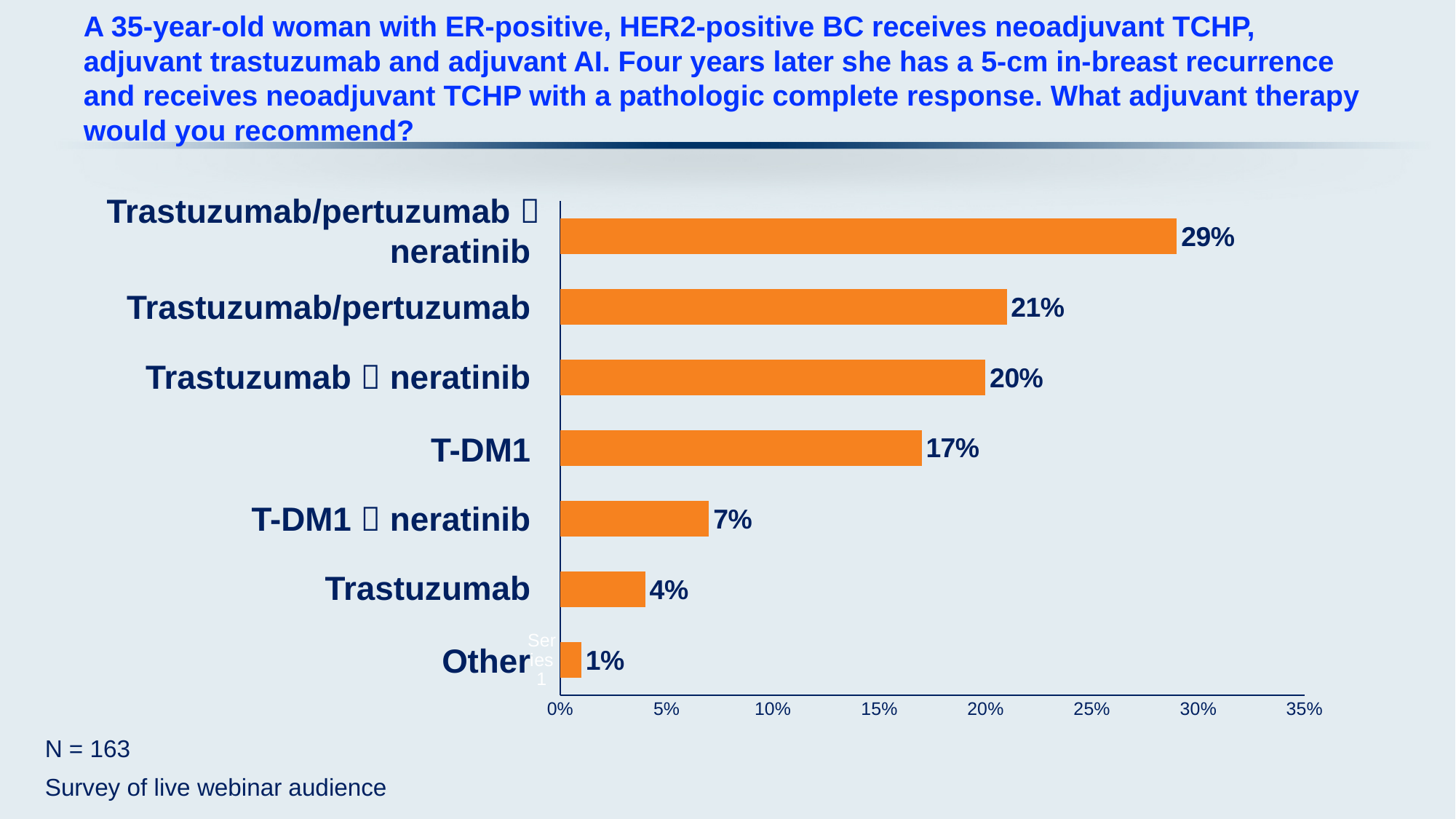
How many categories (response options) are plotted in the chart? 7 Which category has the highest value in the chart? Trastuzumab/pertuzumab followed by neratinib What percentage of respondents chose Other? 1% Which category has the lowest value in the chart? Other What is the value of the top bar, Trastuzumab/pertuzumab followed by neratinib? 29% What percentage of respondents chose Trastuzumab alone? 4% What percentage of respondents chose Trastuzumab/pertuzumab? 21% What percentage of respondents chose T-DM1? 17% What is the highest value shown on the x axis of the chart? 35% What kind of chart is shown on the slide? Bar chart Which is larger, the value for T-DM1 or the value for Trastuzumab? T-DM1 What is the difference between the values for Trastuzumab/pertuzumab and T-DM1? 4%